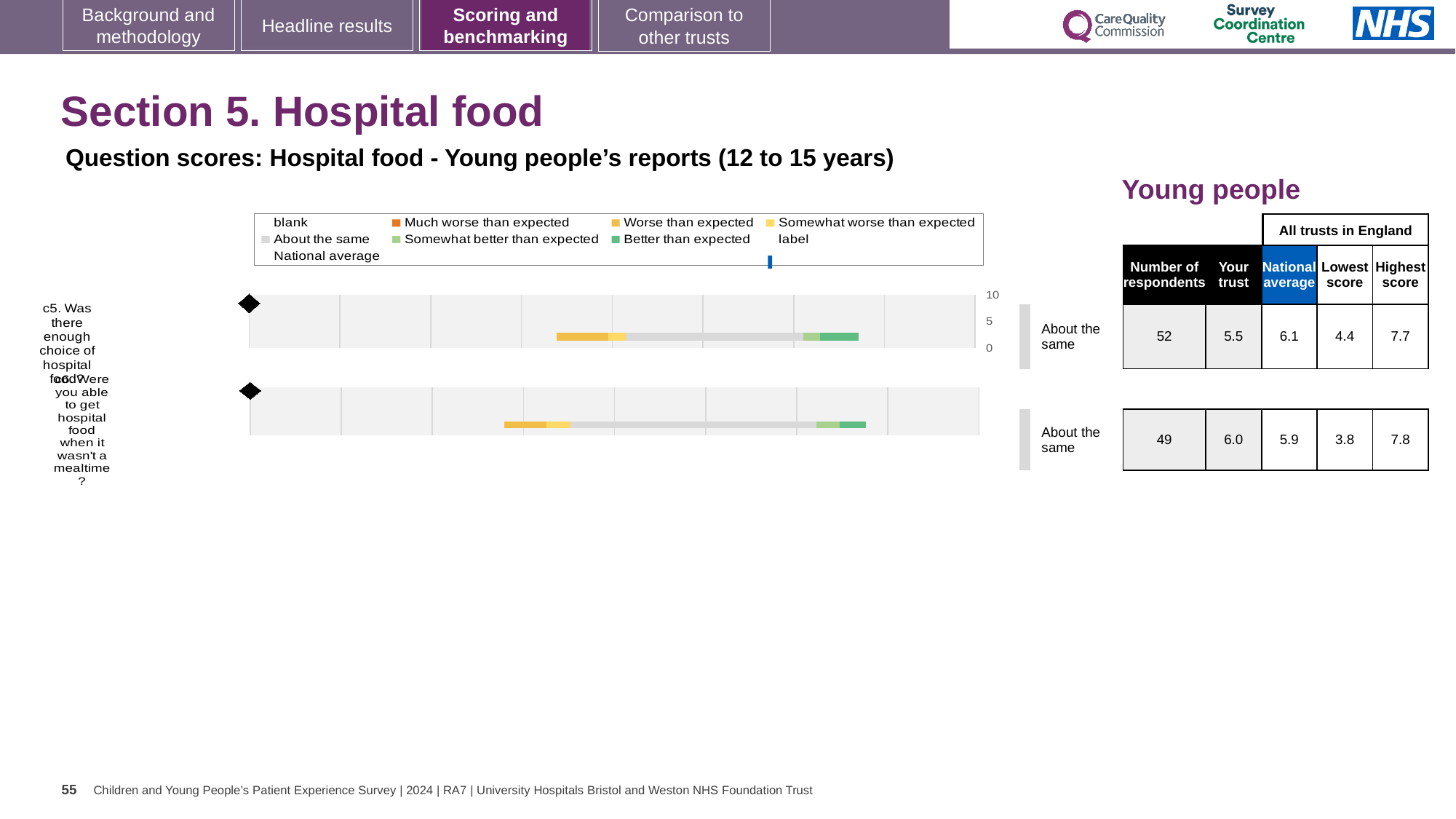
What is the difference between the highest score and the lowest score for question c5? 3.3 What is the 'Your trust' score for question c6 (Were you able to get hospital food when it wasn't a mealtime?)? 6.0 What is the national average score for question c5? 6.1 How many survey questions are plotted in the chart? 2 By how much does the trust's score for c6 exceed the national average for c6? 0.1 Which benchmark category is shown for question c5? About the same What is the 'Your trust' score for question c5 (Was there enough choice of hospital food?)? 5.5 What colour represents 'Better than expected' in the legend? green Which question has the higher 'Your trust' score, c5 or c6? c6 Is the trust's score for question c6 greater or less than 5? greater What kind of chart is shown on the slide? bar chart How many respondents answered question c6? 49